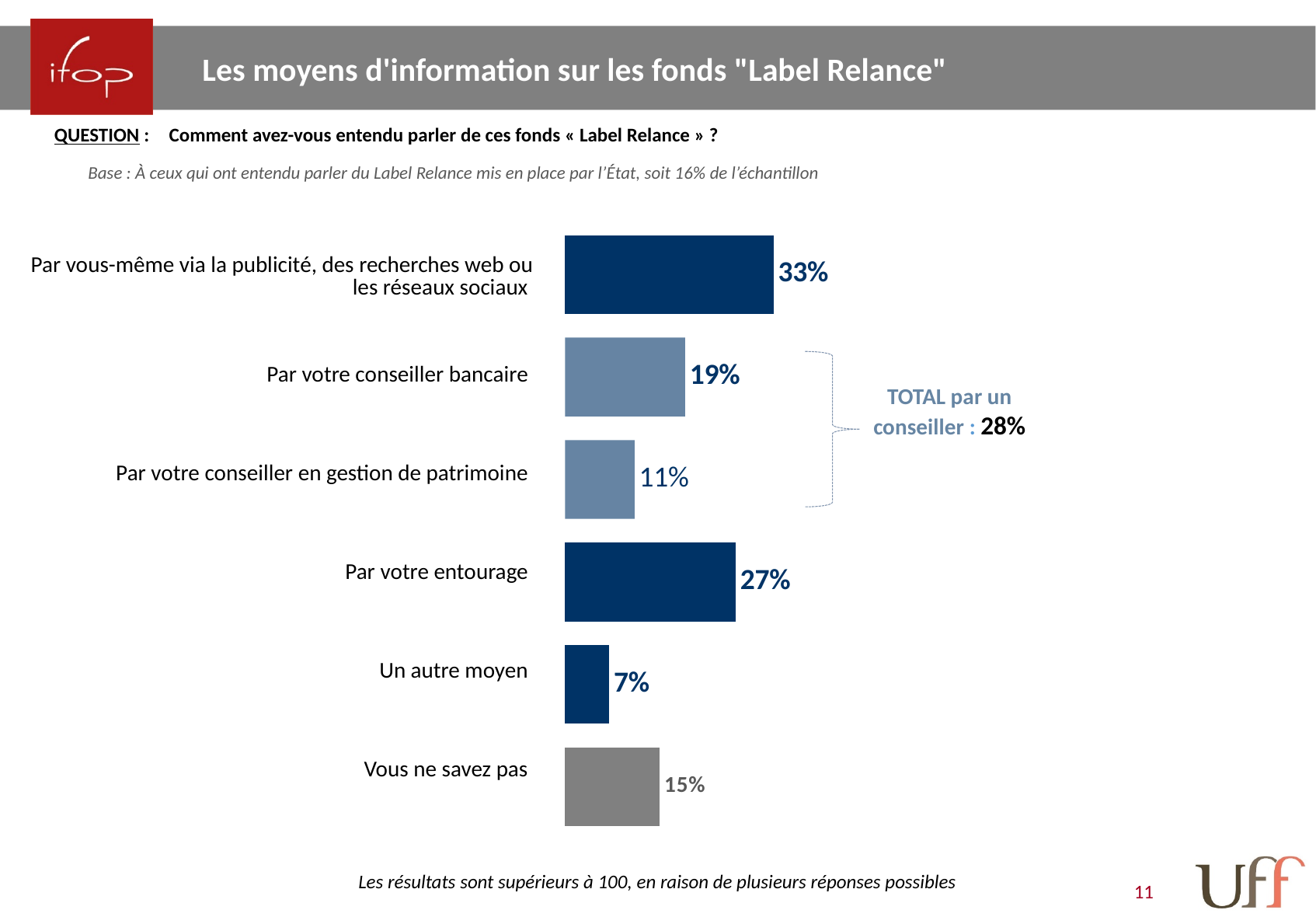
How many categories are shown in the chart? 6 What is the "TOTAL par un conseiller" value shown next to the chart? 28% What is the value for "Vous ne savez pas"? 15% Which category has the lowest value? Un autre moyen What is the value for "Par votre conseiller bancaire"? 19% What is the value for "Par vous-même via la publicité, des recherches web ou les réseaux sociaux"? 33% What kind of chart is shown on the slide? Bar chart What is the value for "Par votre conseiller en gestion de patrimoine"? 11% Which category has the highest value? Par vous-même via la publicité, des recherches web ou les réseaux sociaux What is the value for "Par votre entourage"? 27% What is the difference between the values for "Par votre entourage" and "Par votre conseiller bancaire"? 8% Which is larger: the value for "Vous ne savez pas" or the value for "Par votre conseiller en gestion de patrimoine"? Vous ne savez pas